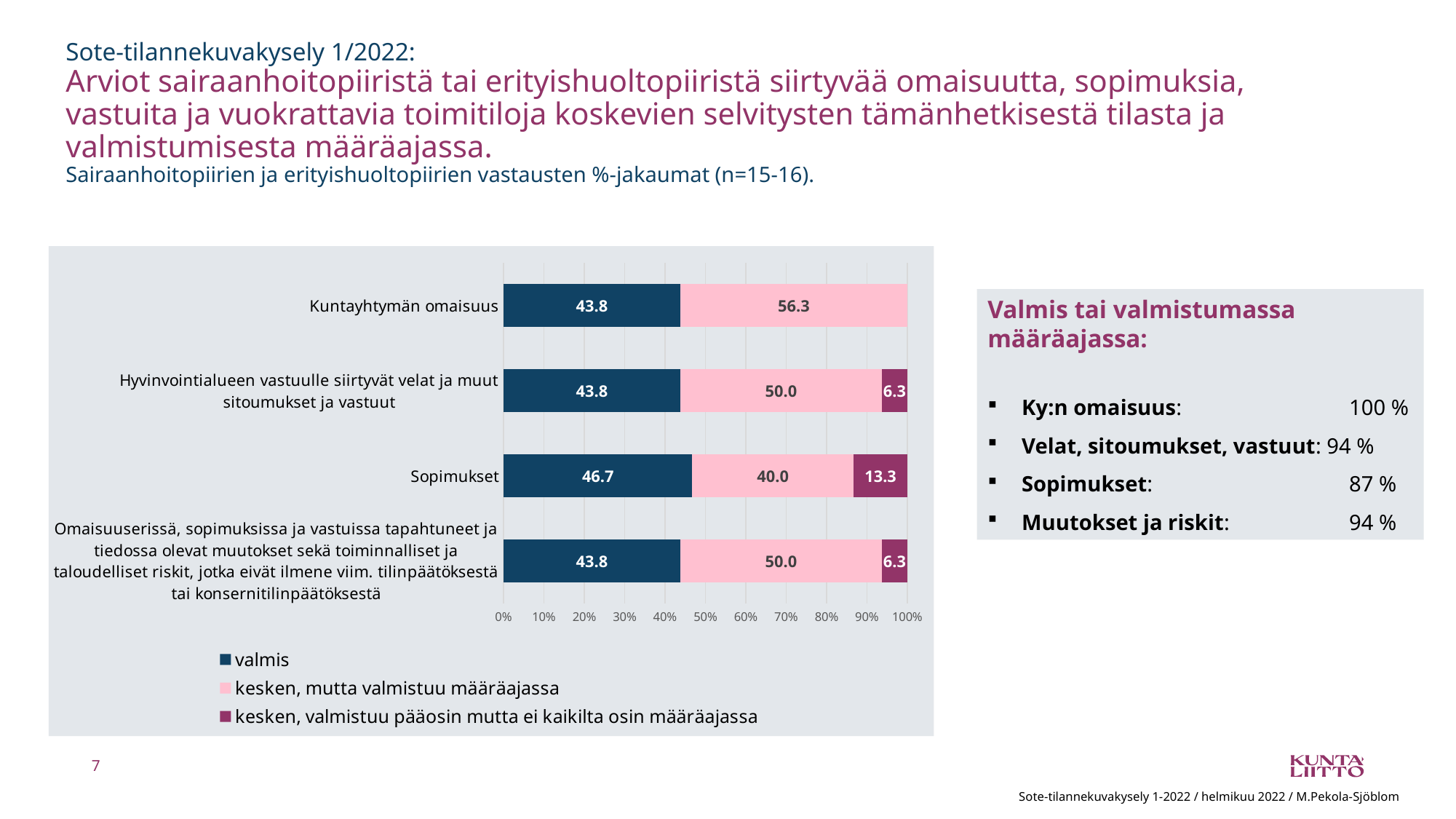
How many categories are shown on the chart? 4 What is the difference between the "kesken, mutta valmistuu määräajassa" value and the "valmis" value for Kuntayhtymän omaisuus? 12.5 What is the value of "kesken, mutta valmistuu määräajassa" for Kuntayhtymän omaisuus? 56.3 Which category has the lowest value for "kesken, mutta valmistuu määräajassa"? Sopimukset Which series is shown in dark blue in the legend? valmis Which category has the highest value for "valmis"? Sopimukset What is the total of the stacked bar for Sopimukset? 100.0 What kind of chart is shown on the slide? Stacked bar chart What is the value of "kesken, valmistuu pääosin mutta ei kaikilta osin määräajassa" for Sopimukset? 13.3 What is the value of "valmis" for Sopimukset? 46.7 How many series does the legend list? 3 For Sopimukset, which is larger: the "valmis" value or the "kesken, mutta valmistuu määräajassa" value? valmis